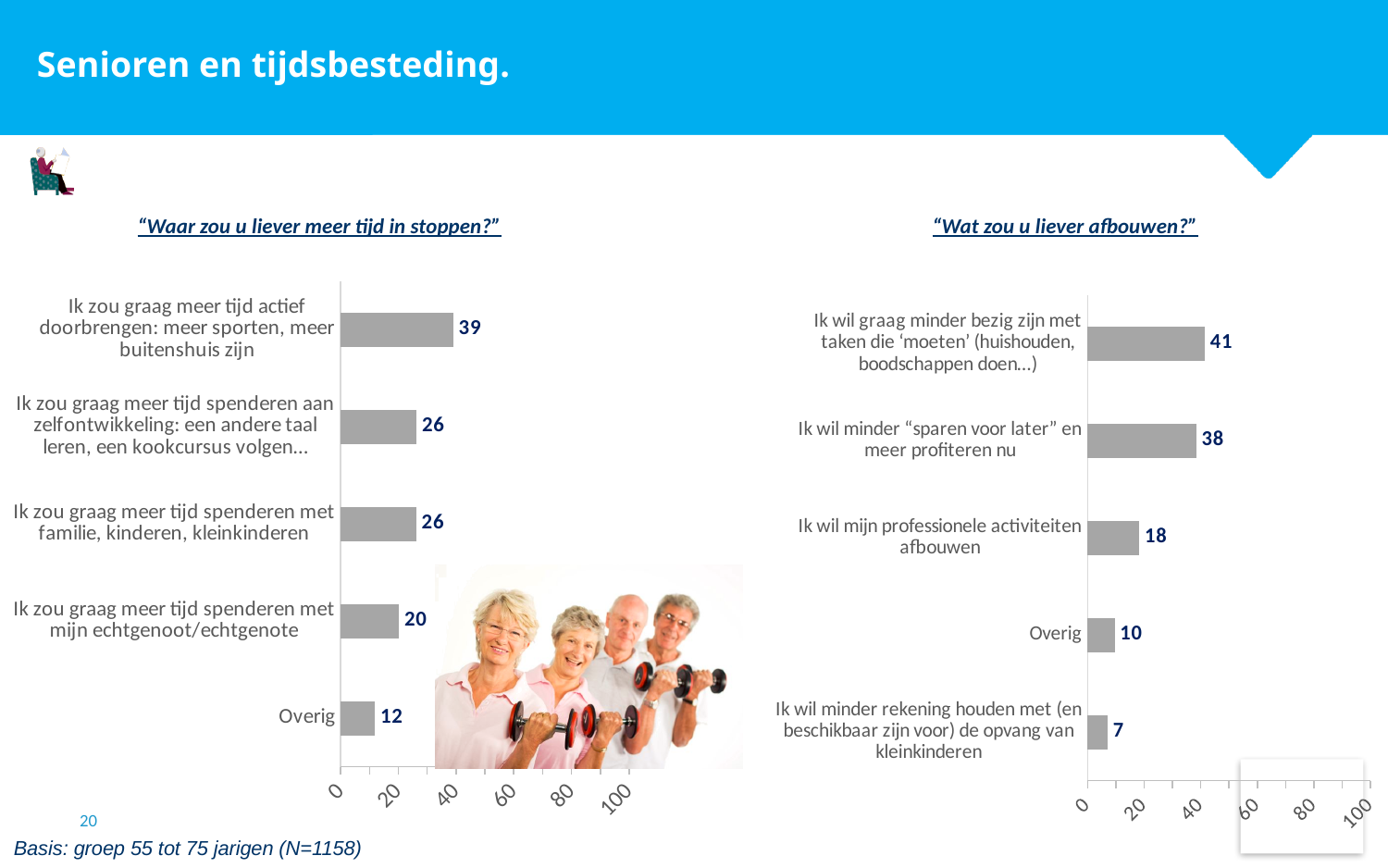
In the chart "Waar zou u liever meer tijd in stoppen?", what is the difference between the value for "Ik zou graag meer tijd actief doorbrengen: meer sporten, meer buitenshuis zijn" and the value for "Overig"? 27 In the chart "Waar zou u liever meer tijd in stoppen?", what is the value for "Ik zou graag meer tijd spenderen met mijn echtgenoot/echtgenote"? 20 In the chart "Wat zou u liever afbouwen?", what is the value for "Ik wil minder "sparen voor later" en meer profiteren nu"? 38 In the chart "Wat zou u liever afbouwen?", what is the difference between the value for "Ik wil graag minder bezig zijn met taken die 'moeten'" and the value for "Ik wil mijn professionele activiteiten afbouwen"? 23 In the chart "Wat zou u liever afbouwen?", is the value for "Ik wil graag minder bezig zijn met taken die 'moeten'" greater or less than 40? greater In the chart "Wat zou u liever afbouwen?", which category has the highest value? Ik wil graag minder bezig zijn met taken die 'moeten' (huishouden, boodschappen doen…) What type of chart is used on the right side of the slide, "Wat zou u liever afbouwen?"? Bar chart In the chart "Waar zou u liever meer tijd in stoppen?", how many categories are shown? 5 In the chart "Wat zou u liever afbouwen?", what is the value for "Ik wil minder rekening houden met (en beschikbaar zijn voor) de opvang van kleinkinderen"? 7 In the chart "Waar zou u liever meer tijd in stoppen?", what is the value for "Ik zou graag meer tijd actief doorbrengen: meer sporten, meer buitenshuis zijn"? 39 In the chart "Wat zou u liever afbouwen?", which is larger: the value for "Ik wil mijn professionele activiteiten afbouwen" or the value for "Overig"? Ik wil mijn professionele activiteiten afbouwen In the chart "Waar zou u liever meer tijd in stoppen?", which category has the lowest value? Overig